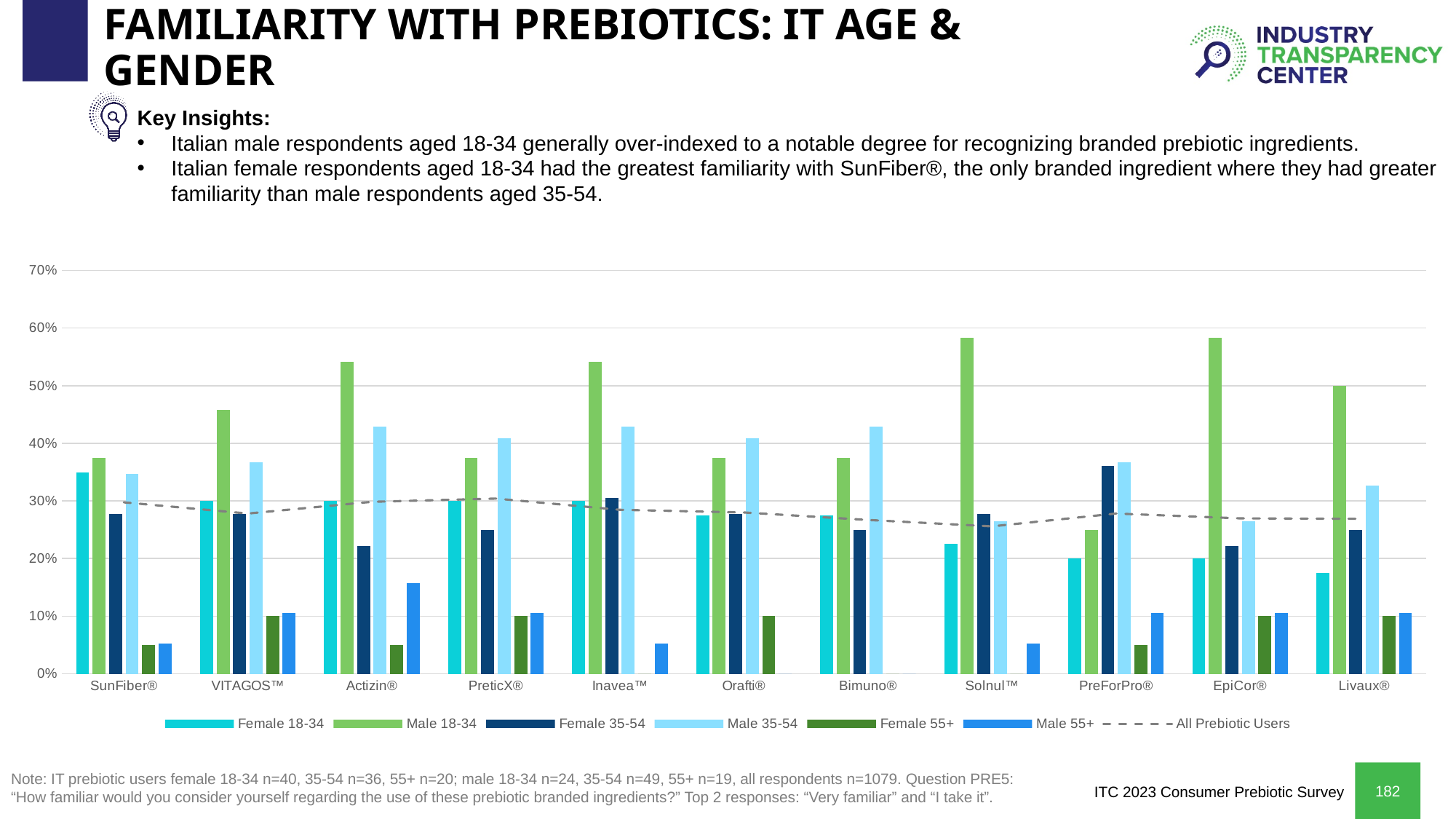
Is the Female 35-54 value for PreForPro® greater or less than 30%? greater What does the dashed grey line in the chart represent? All Prebiotic Users Is the Male 18-34 value for Solnul™ greater or less than 50%? greater How many series does the legend list? 7 For Actizin®, which is larger: the Male 18-34 value or the Male 35-54 value? Male 18-34 Is the Male 35-54 value for Actizin® greater or less than 40%? greater What kind of chart is shown on the slide? combination bar and line chart For PreForPro®, which is larger: the Female 35-54 value or the Male 18-34 value? Female 35-54 For which ingredient is the Female 18-34 value highest? SunFiber® How many branded prebiotic ingredients are shown along the x axis? 11